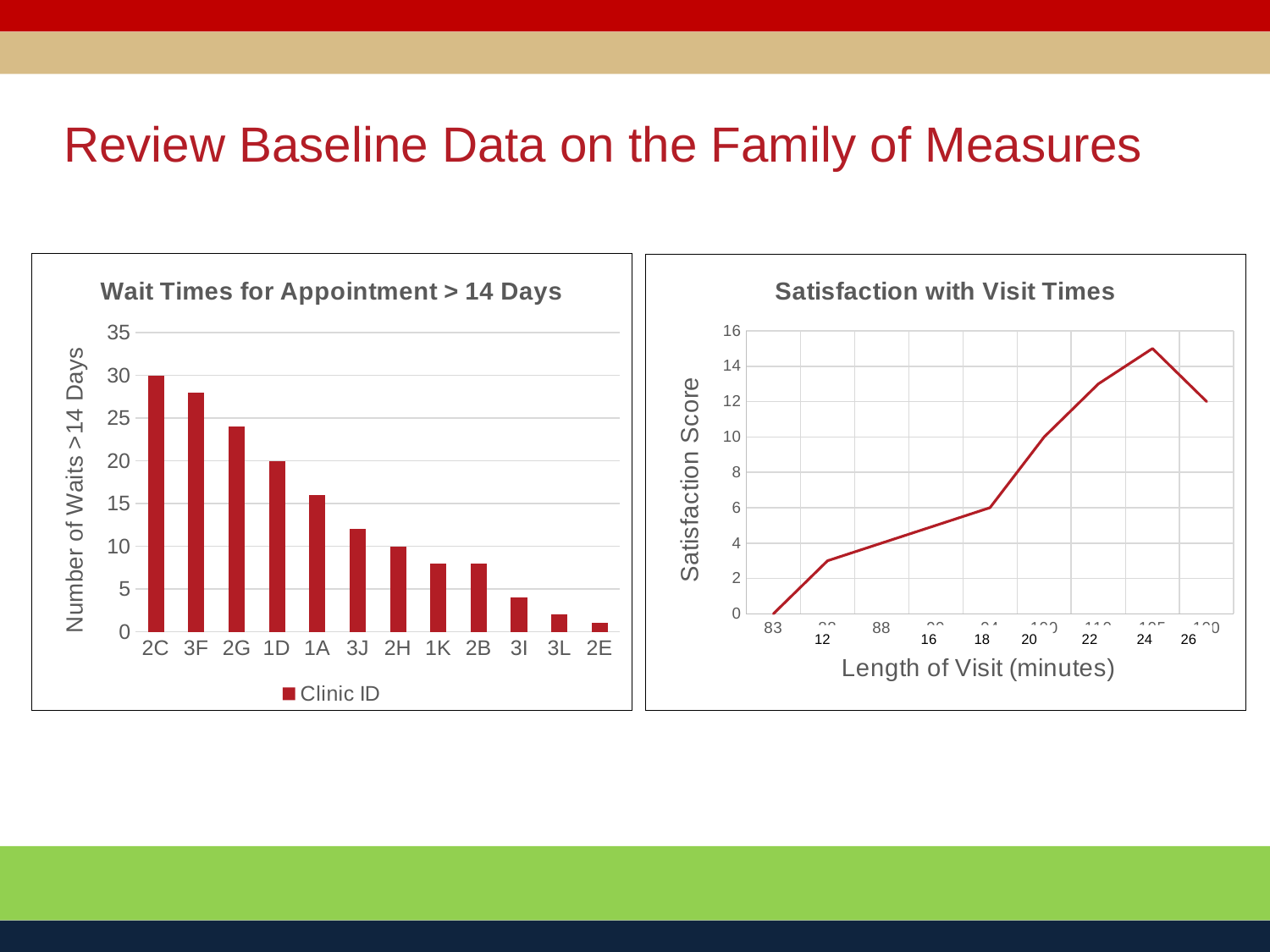
On the 'Wait Times for Appointment > 14 Days' chart, which clinic has more waits over 14 days, 2G or 1A? 2G On the 'Wait Times for Appointment > 14 Days' chart, what is the legend entry? Clinic ID On the 'Wait Times for Appointment > 14 Days' chart, what is the number of waits over 14 days for clinic 1D? 20 On the 'Satisfaction with Visit Times' chart, what type of chart is shown? line chart On the 'Wait Times for Appointment > 14 Days' chart, which clinic has the lowest number of waits over 14 days? 2E On the 'Wait Times for Appointment > 14 Days' chart, how many clinics are shown on the x axis? 12 On the 'Wait Times for Appointment > 14 Days' chart, what is the number of waits over 14 days for clinic 2C? 30 On the 'Wait Times for Appointment > 14 Days' chart, what type of chart is shown? bar chart On the 'Wait Times for Appointment > 14 Days' chart, is the value for clinic 3F greater or less than 25? greater On the 'Satisfaction with Visit Times' chart, is the highest satisfaction score greater or less than 14? greater On the 'Wait Times for Appointment > 14 Days' chart, which clinic has the highest number of waits over 14 days? 2C On the 'Wait Times for Appointment > 14 Days' chart, is the value for clinic 3I greater or less than 5? less